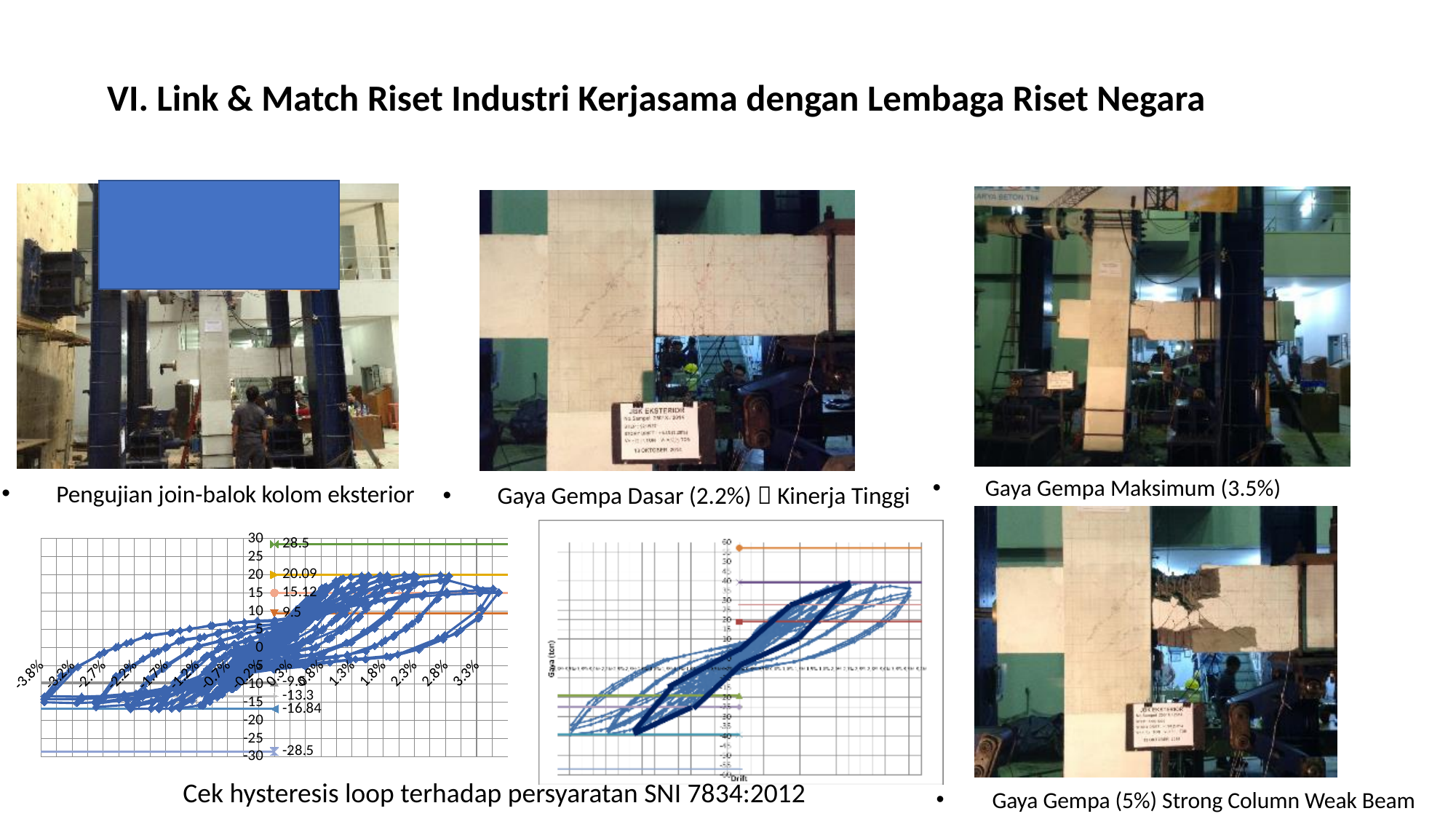
On the bottom-left chart, is the maximum positive value reached by the hysteresis loop greater or less than 10? greater On the bottom-left chart, what is the difference between the reference lines labelled 28.5 and 20.09? 8.41 On the bottom-left chart, what value is labelled on the topmost horizontal reference line? 28.5 On the bottom-left chart, what is the highest tick value shown on the vertical axis? 30 What is the vertical axis title of the middle chart on the slide? Gaya (ton) What kind of chart is the bottom-left chart on the slide? line chart On the bottom-left chart, what is the leftmost label on the horizontal axis? -3.8% On the bottom-left chart, which labelled reference line is larger, 15.12 or 9.5? 15.12 On the bottom-left chart, how many labelled horizontal reference lines are shown? 8 On the bottom-left chart, what value is labelled on the lowest horizontal reference line? -28.5 On the bottom-left chart, what is the difference between the reference lines labelled 20.09 and 15.12? 4.97 On the bottom-left chart, what value is labelled on the yellow horizontal reference line just above 20? 20.09